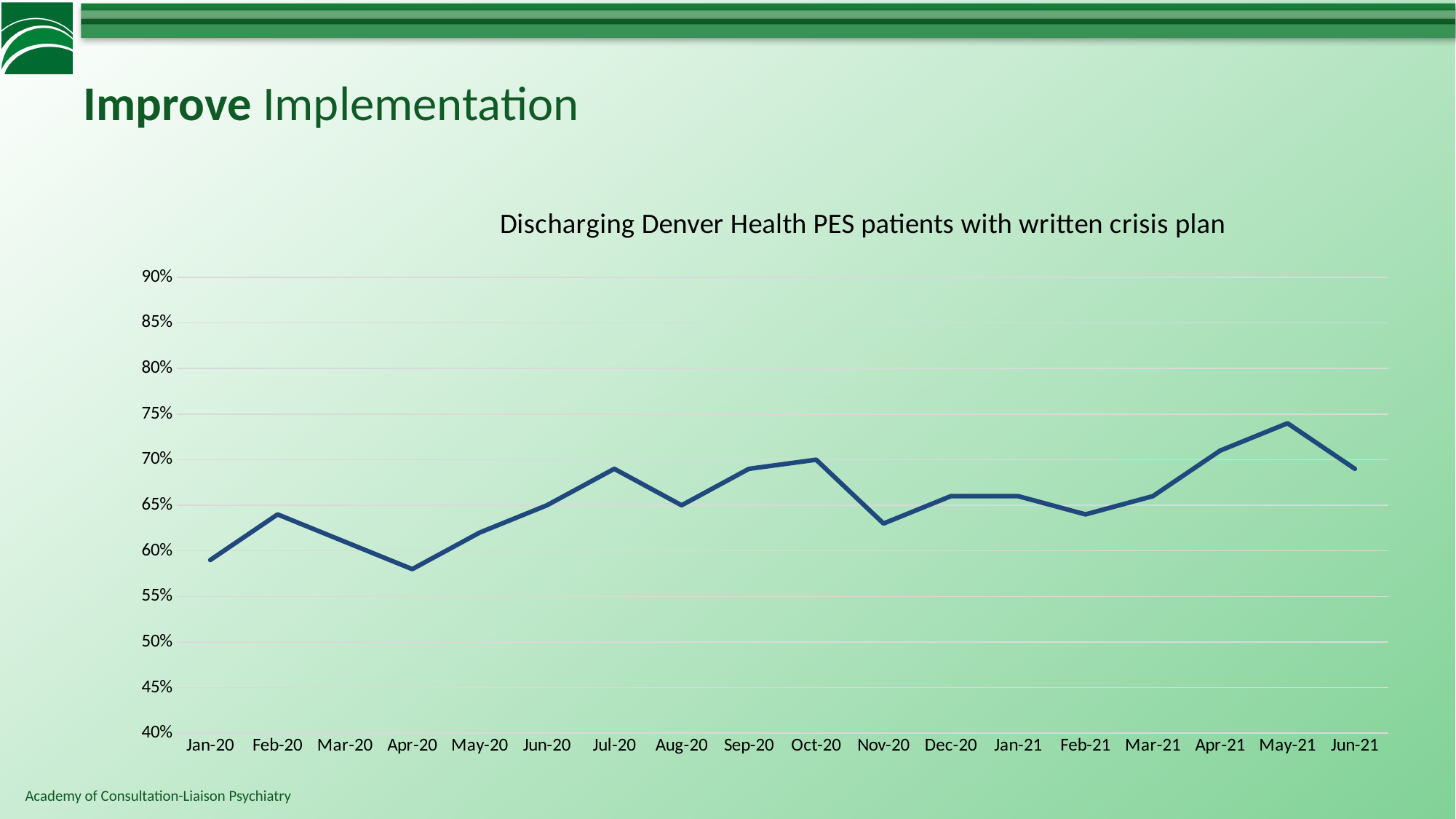
What is the title of the chart? Discharging Denver Health PES patients with written crisis plan Is the value for May-21 greater or less than 70%? greater Overall, do the values rise or fall from Jan-20 to Jun-21? rise How many months are plotted on the x axis? 18 What kind of chart is shown on the slide? line chart Is the value for Jul-20 greater or less than 65%? greater Which is larger, the value for Jul-20 or the value for Nov-20? Jul-20 Which month has the lowest value? Apr-20 Which month has the highest value? May-21 What is the value for Oct-20? 70% Is the value for Apr-20 greater or less than 60%? less